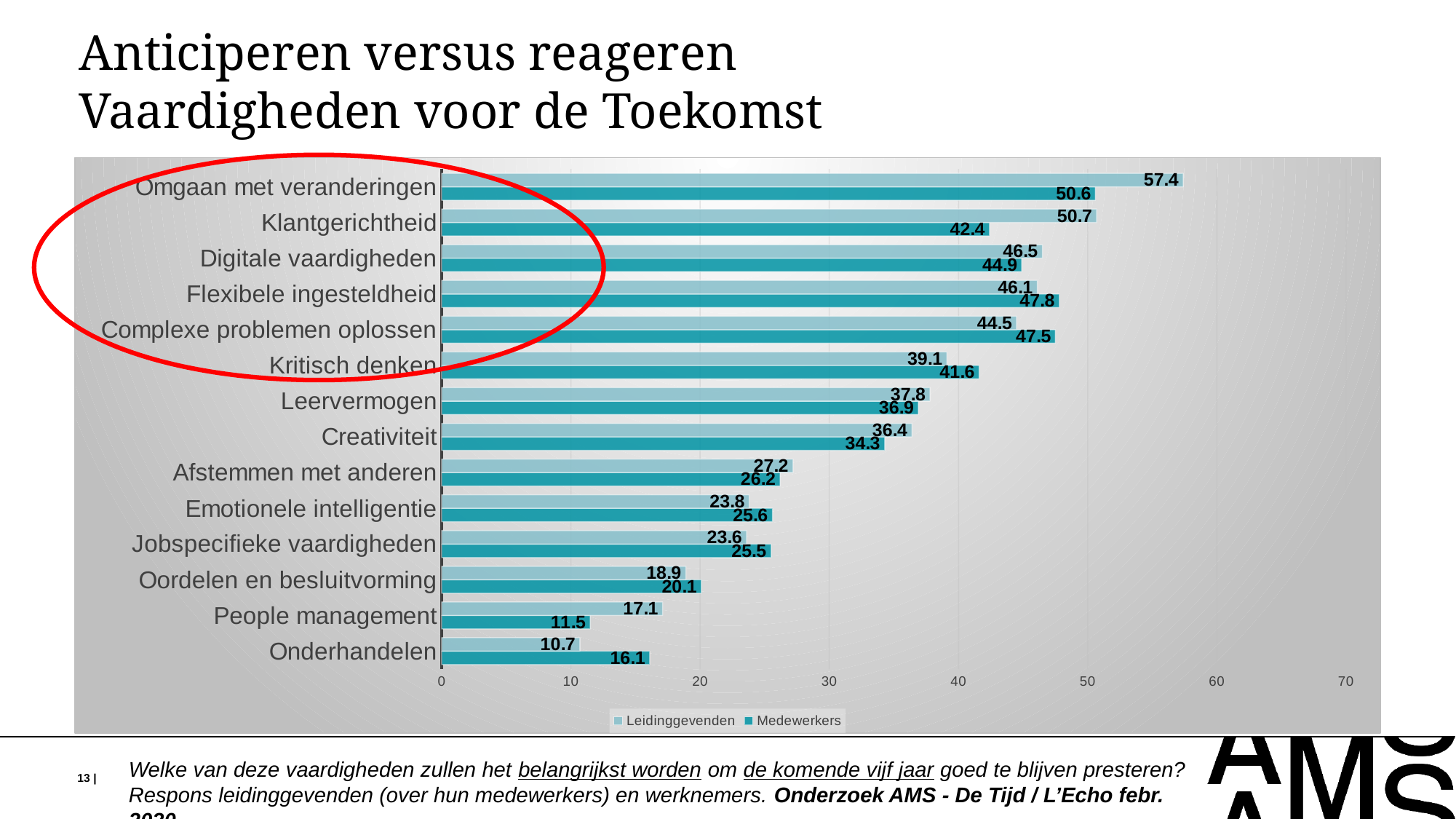
What is the Leidinggevenden value for Omgaan met veranderingen? 57.4 What is the Medewerkers value for Onderhandelen? 16.1 What is the Medewerkers value for Klantgerichtheid? 42.4 How many categories are shown on the chart? 14 Which category has the lowest Medewerkers value? People management What kind of chart is shown on the slide? Bar chart Which category has the highest Leidinggevenden value? Omgaan met veranderingen For People management, which series has the larger value, Leidinggevenden or Medewerkers? Leidinggevenden What is the difference between the Leidinggevenden and Medewerkers values for Klantgerichtheid? 8.3 For Complexe problemen oplossen, which series has the larger value, Leidinggevenden or Medewerkers? Medewerkers Which series is shown in the darker teal colour? Medewerkers How many series does the legend list? 2